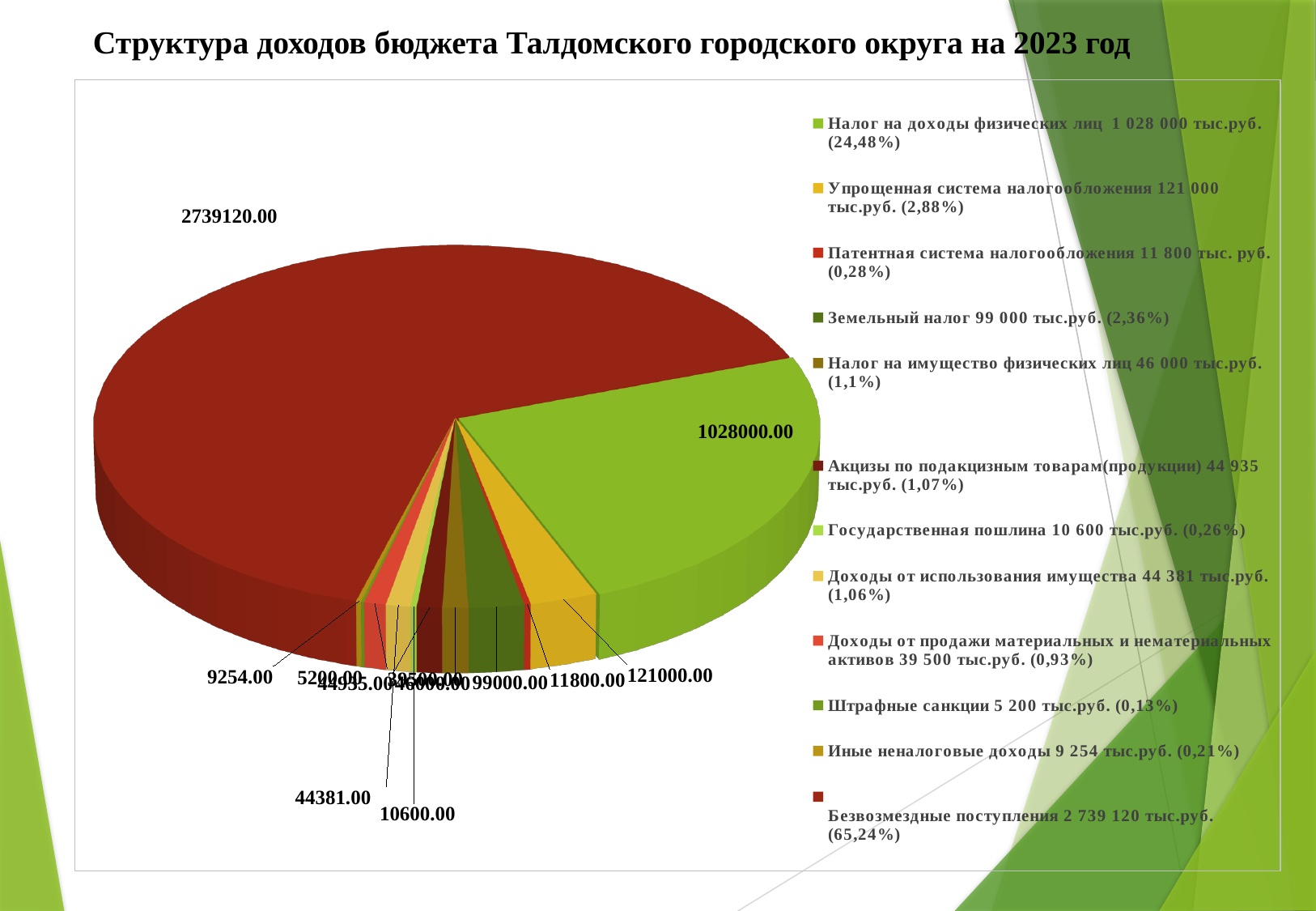
What share of the pie does Налог на доходы физических лиц represent, according to the legend? 24,48% How many categories does the legend list? 12 Which category has the largest slice of the pie? Безвозмездные поступления What kind of chart is shown on the slide? Pie chart What is the title of the chart? Структура доходов бюджета Талдомского городского округа на 2023 год What is the data label value for Налог на доходы физических лиц? 1028000.00 What is the difference between the values for Безвозмездные поступления and Налог на доходы физических лиц? 1711120.00 What is the data label value for Безвозмездные поступления? 2739120.00 What is the data label value for Земельный налог? 99000.00 Which is larger: Упрощенная система налогообложения or Земельный налог? Упрощенная система налогообложения What share of the pie does Безвозмездные поступления represent, according to the legend? 65,24% Which category has the smallest slice of the pie? Штрафные санкции